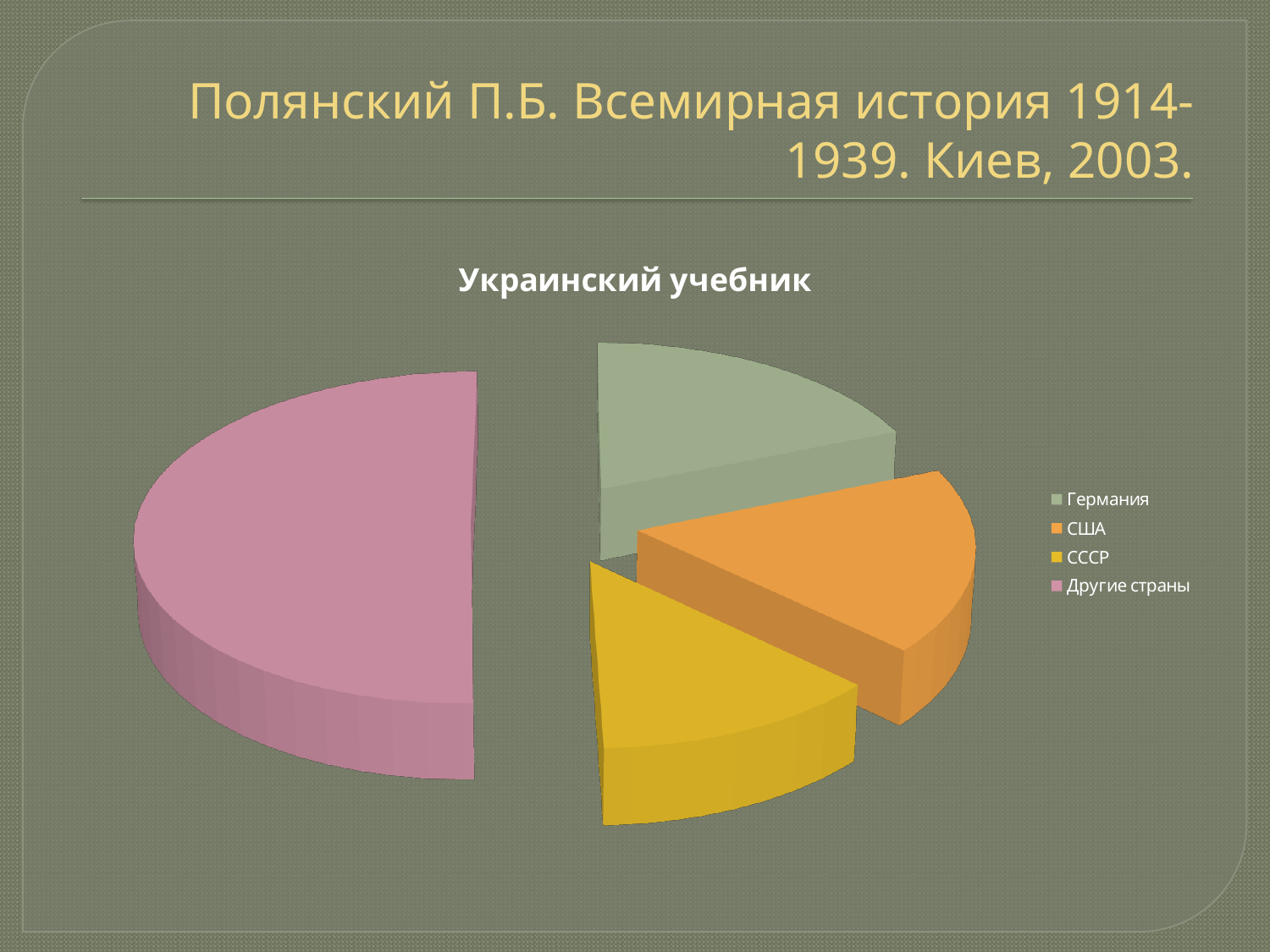
How many slices does the pie chart have? 4 Which category is shown in pink in the pie chart? Другие страны Which is larger, the slice for Другие страны or the slice for США? Другие страны How many entries does the legend list? 4 What kind of chart is shown on the slide? pie chart Which is larger, the slice for Другие страны or the slice for СССР? Другие страны Which category has the largest slice of the pie? Другие страны What is the title of the chart? Украинский учебник Which is larger, the slice for Другие страны or the slice for Германия? Другие страны